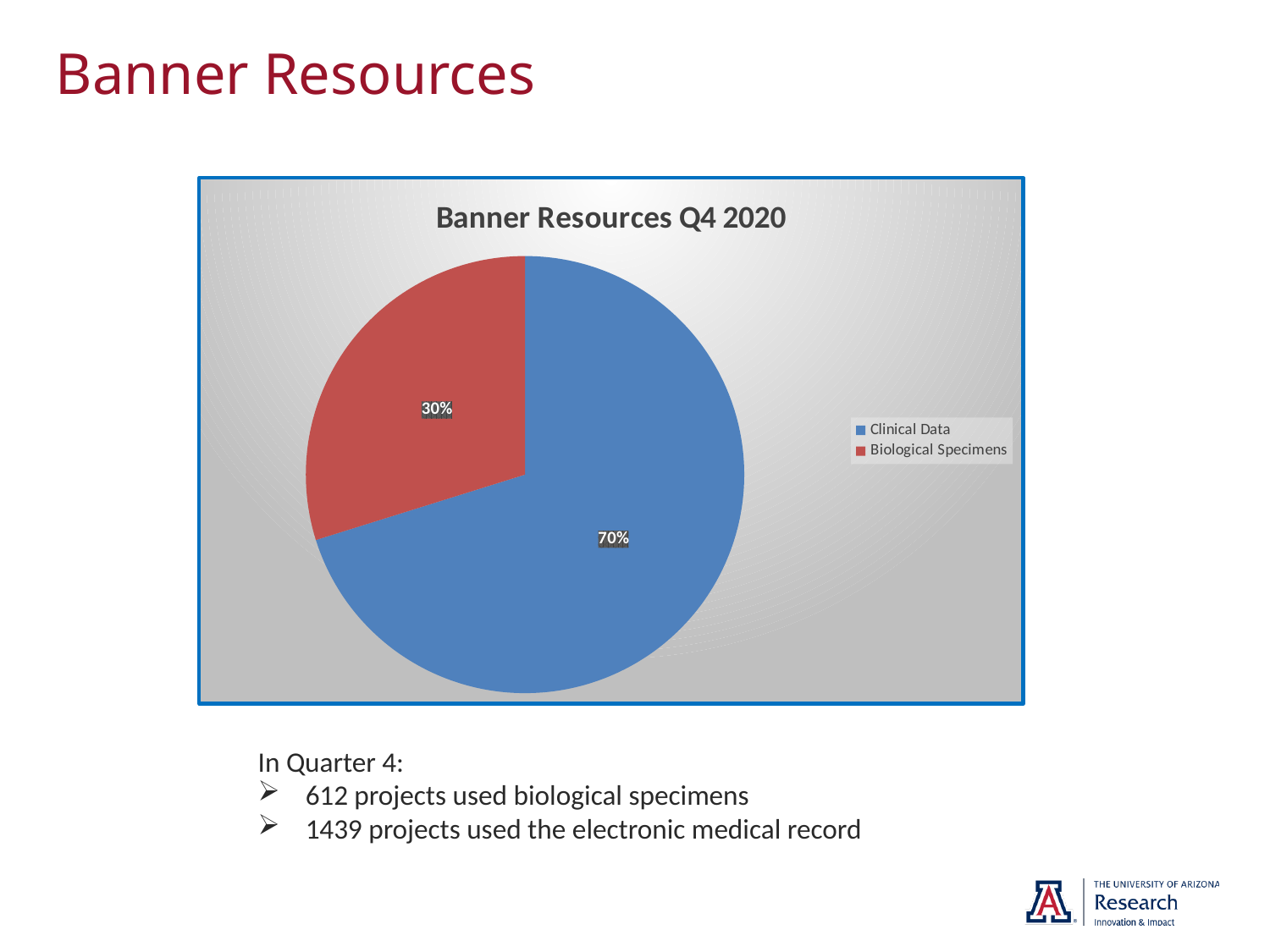
How many slices does the pie chart have? 2 What percentage of the pie chart is Clinical Data? 70% What colour is the Clinical Data slice in the pie chart? Blue What is the difference in percentage points between the Clinical Data and Biological Specimens slices? 40 What type of chart is shown on the slide? Pie chart What is the title of the chart? Banner Resources Q4 2020 What share of the pie does the Biological Specimens slice represent? 30% Which slice is larger, Clinical Data or Biological Specimens? Clinical Data What percentage of the pie chart is Biological Specimens? 30% Which category has the smallest share of the pie chart? Biological Specimens How many entries does the chart legend list? 2 Which category has the largest share of the pie chart? Clinical Data